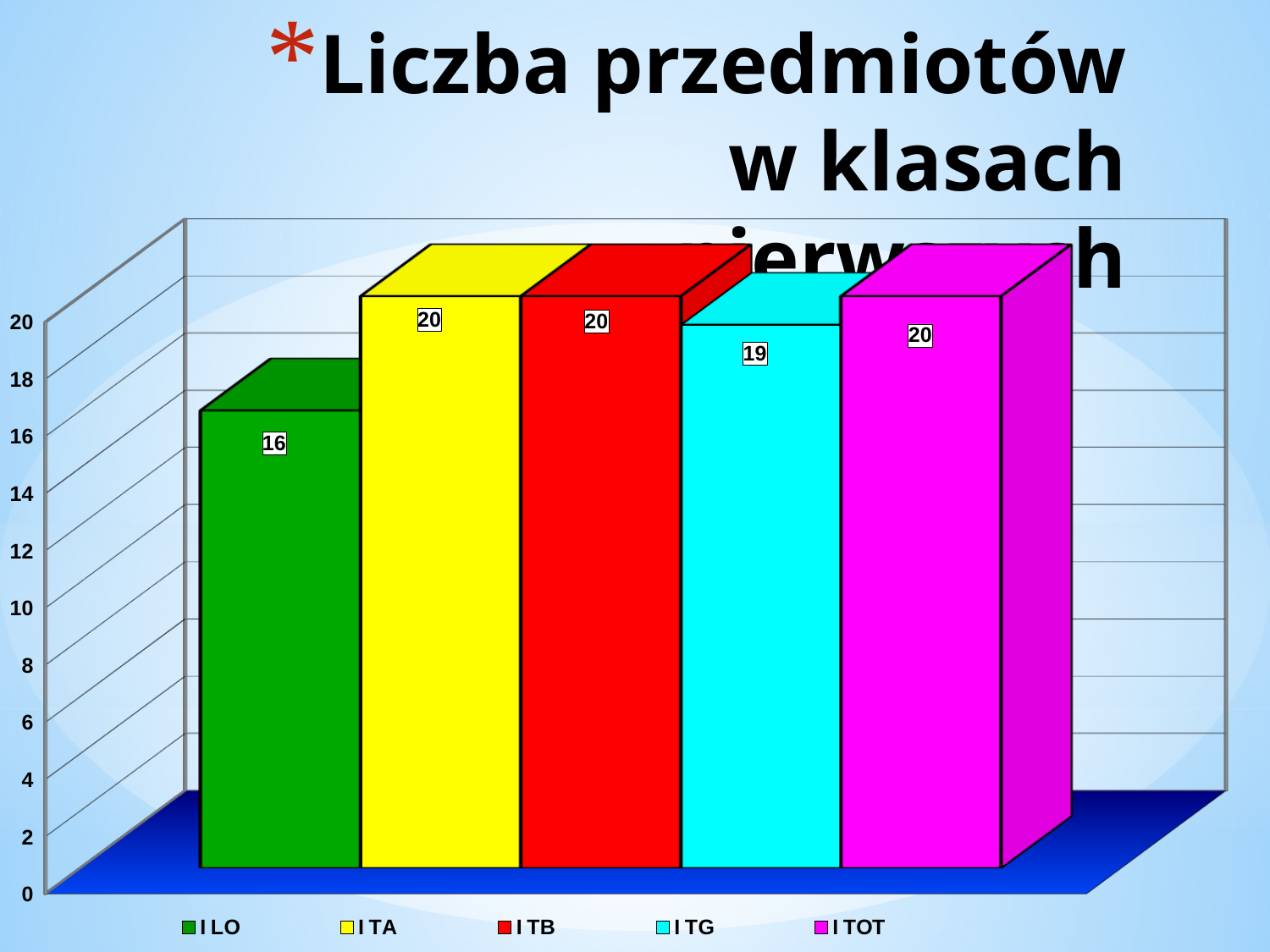
How many entries does the legend list? 5 Which category has the lowest value? I LO What is the value for I TG? 19 What is the value for I LO? 16 What is the difference between the values for I TB and I TG? 1 Is the value for I LO greater or less than 18? less Which is larger, the value for I TG or the value for I LO? I TG What is the value for I TA? 20 What is the difference between the values for I TA and I LO? 4 What is the value for I TOT? 20 What kind of chart is shown on the slide? bar chart How many bars are shown in the chart? 5